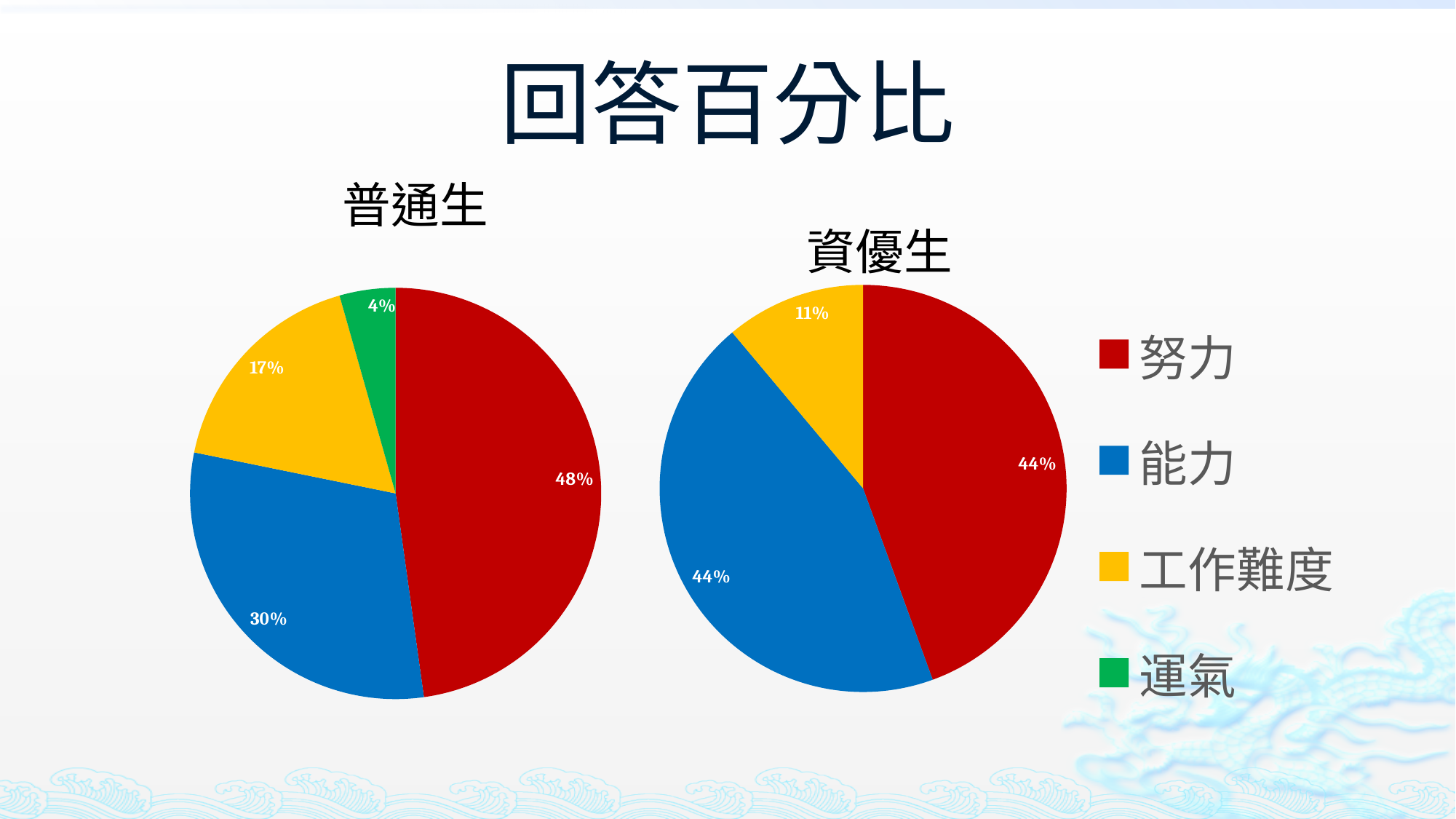
In the 普通生 pie chart, which category has the largest share? 努力 What type of chart is used on this slide? Pie chart How many categories does the legend list? 4 In the 普通生 pie chart, what is the difference between the shares for 努力 and 能力? 18% In the 普通生 pie chart, what percentage is shown for 運氣? 4% In the 普通生 pie chart, which category has the smallest share? 運氣 In the 資優生 pie chart, what is the difference between the shares for 能力 and 工作難度? 33% In the 普通生 pie chart, what percentage is shown for 努力? 48% In the 資優生 pie chart, what percentage is shown for 工作難度? 11% In the 普通生 pie chart, what percentage is shown for 能力? 30% Which is larger: the share for 工作難度 in the 普通生 pie chart or in the 資優生 pie chart? 普通生 In the 資優生 pie chart, which category has the smallest share? 工作難度